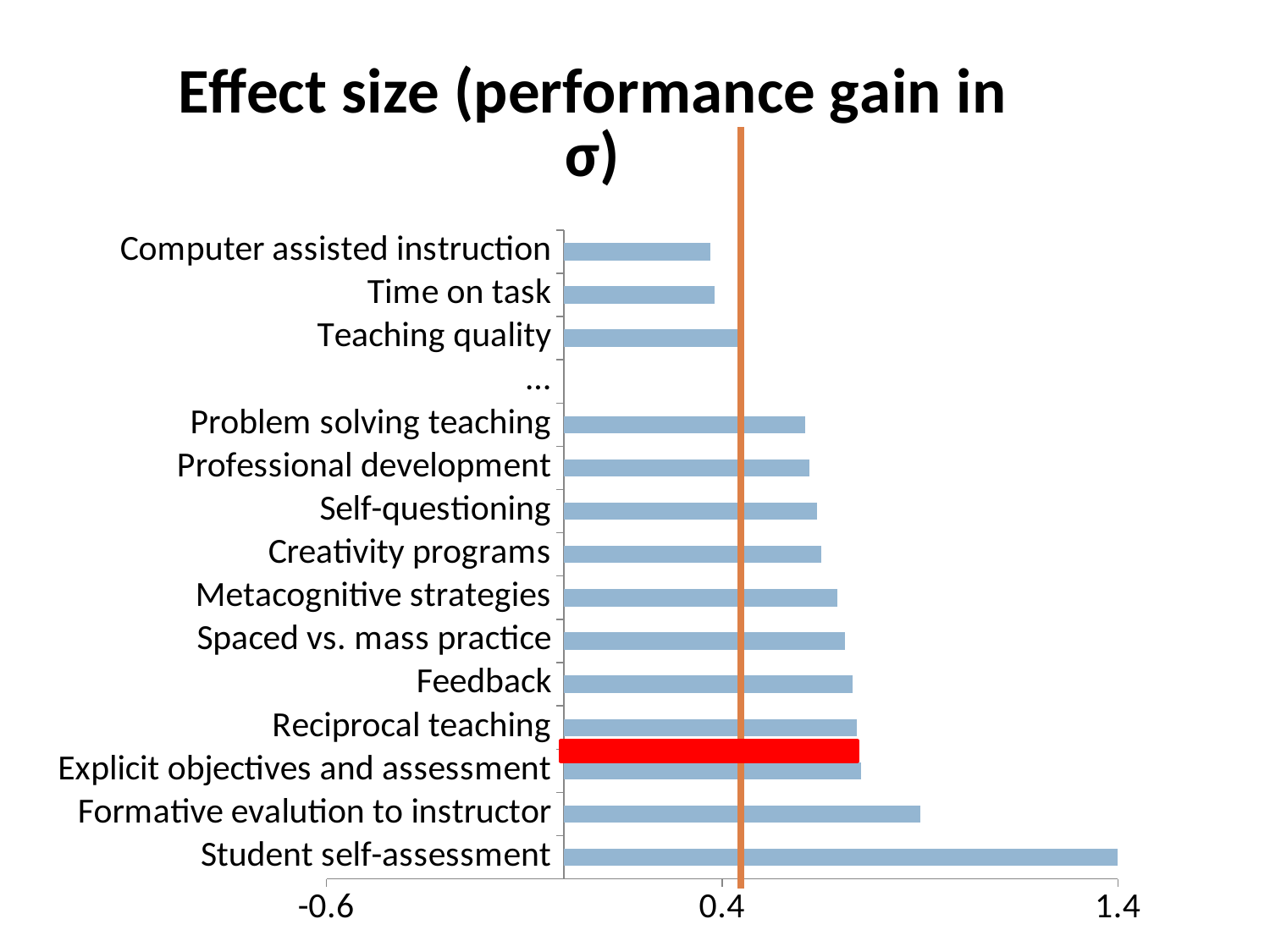
Is the value for Student self-assessment greater or less than 0.4? greater Which is larger, the value for Formative evalution to instructor or the value for Feedback? Formative evalution to instructor Which category's bar is highlighted in red? Explicit objectives and assessment Which is larger, the value for Student self-assessment or the value for Formative evalution to instructor? Student self-assessment Is the value for Metacognitive strategies greater or less than 0.4? greater Is the value for Formative evalution to instructor greater or less than 0.4? greater Which category has the highest effect size? Student self-assessment What is the title of the chart? Effect size (performance gain in σ) What kind of chart is shown on the slide? bar chart Which is larger, the value for Problem solving teaching or the value for Computer assisted instruction? Problem solving teaching